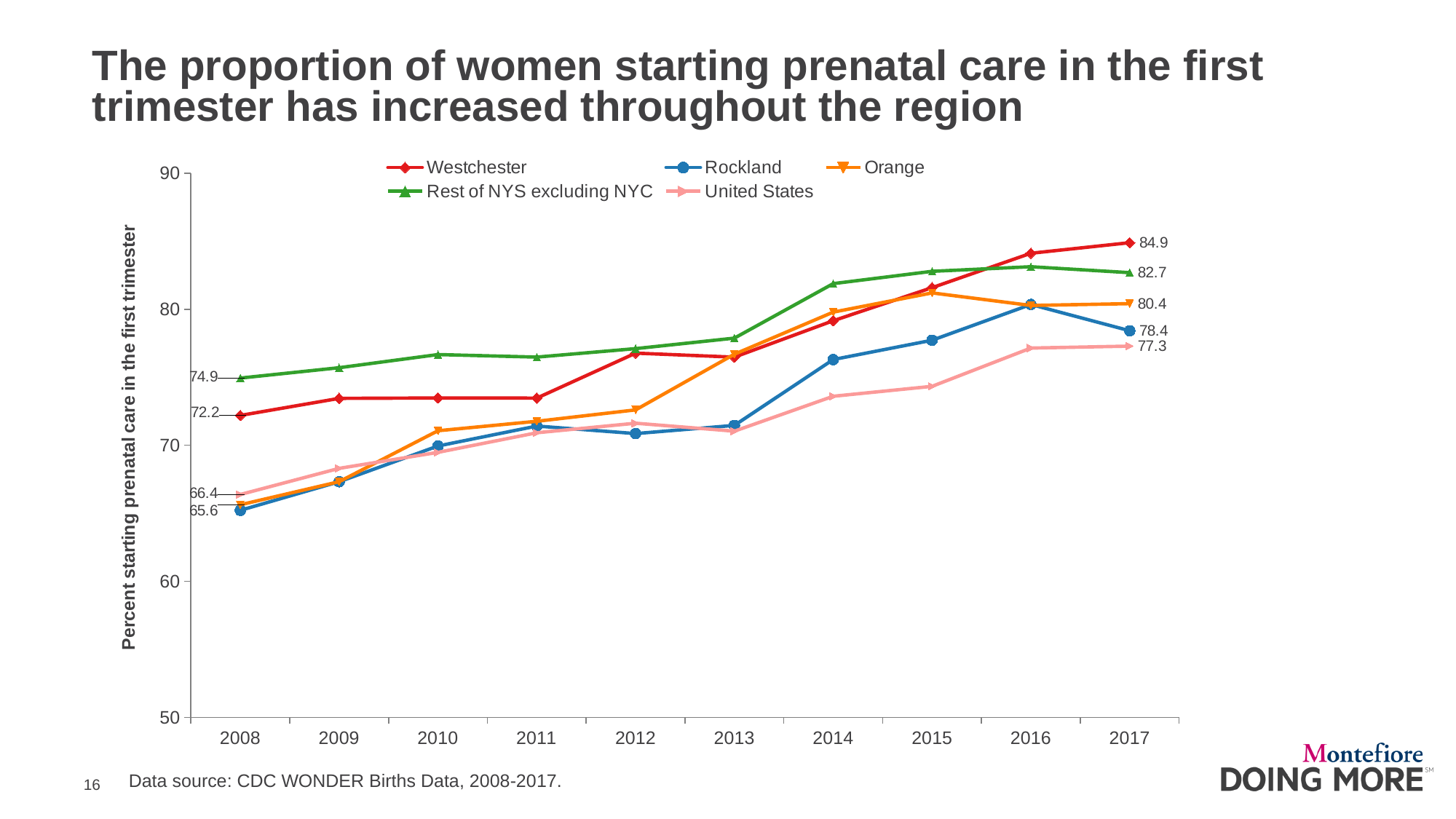
By how much did the Westchester value increase from 2008 to 2017? 12.7 What is the value for Westchester in 2017? 84.9 What kind of chart is shown on the slide? line chart What is the value for the United States in 2017? 77.3 How many series does the legend list? 5 Does the Westchester line generally rise or fall from 2008 to 2017? rise What is the value for Rest of NYS excluding NYC in 2008? 74.9 Is the value for Rest of NYS excluding NYC in 2014 greater or less than 80? greater What is the value for Rockland in 2017? 78.4 Which series has the lowest value in 2017? United States Which series has the highest value in 2017? Westchester How many years are plotted along the x axis? 10